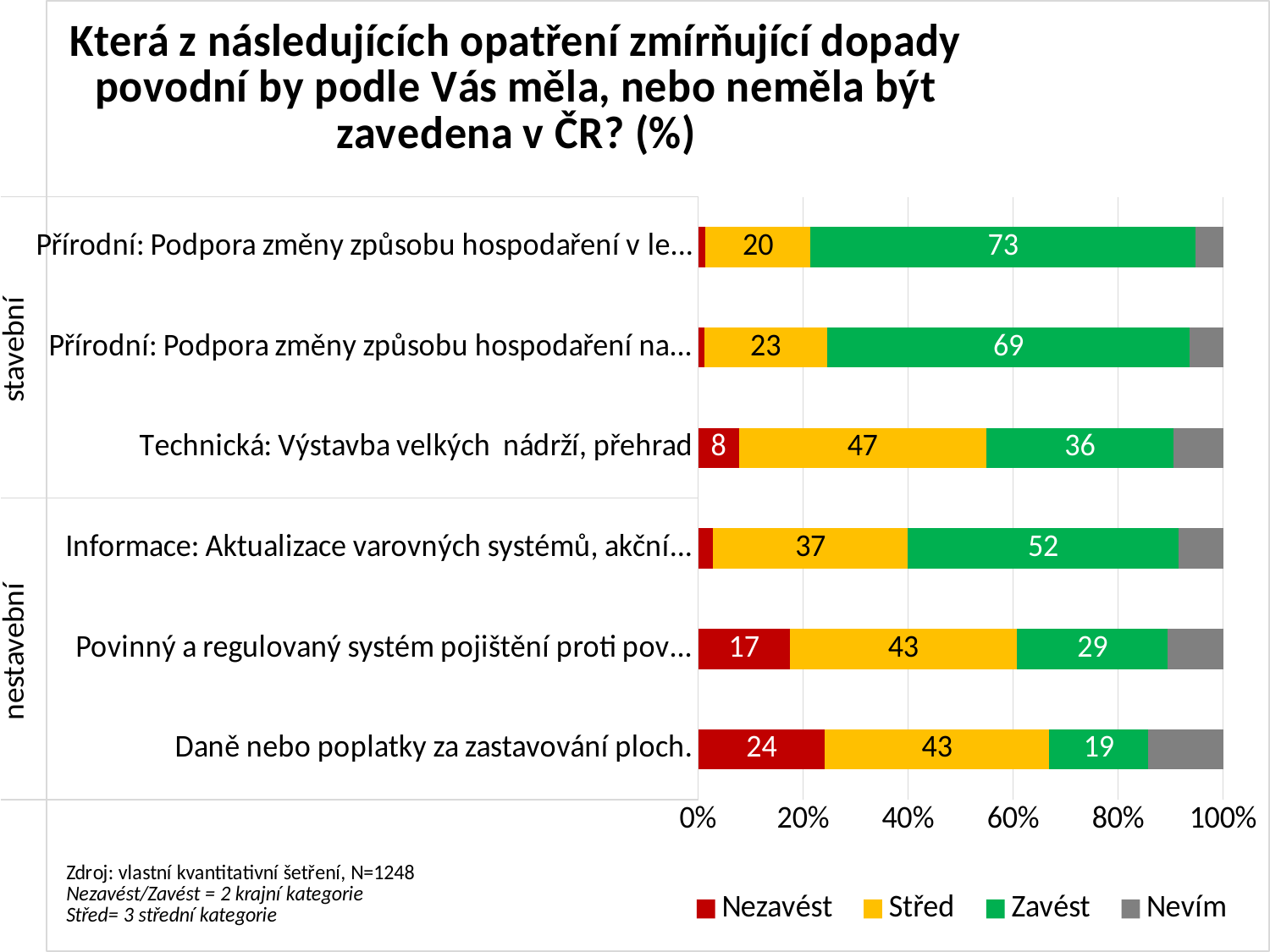
What is the difference between the Zavést values of the two 'Přírodní' measures (73 and 69)? 4 What kind of chart is shown on the slide? stacked bar chart What are the four legend entries of the chart? Nezavést, Střed, Zavést, Nevím Which has a larger Střed value: 'Technická: Výstavba velkých nádrží, přehrad' or 'Informace: Aktualizace varovných systémů, akční…'? Technická: Výstavba velkých nádrží, přehrad What is the Střed value for 'Daně nebo poplatky za zastavování ploch.'? 43 Which measure has the highest Zavést value? Přírodní: Podpora změny způsobu hospodaření v le… How many measures (bars) are shown in the chart? 6 What is the difference between the Nezavést values for 'Daně nebo poplatky za zastavování ploch.' and 'Technická: Výstavba velkých nádrží, přehrad'? 16 How many series does the legend list? 4 Which measure has the lowest Zavést value? Daně nebo poplatky za zastavování ploch. What is the Nezavést value for 'Daně nebo poplatky za zastavování ploch.'? 24 What is the Zavést value for 'Technická: Výstavba velkých nádrží, přehrad'? 36